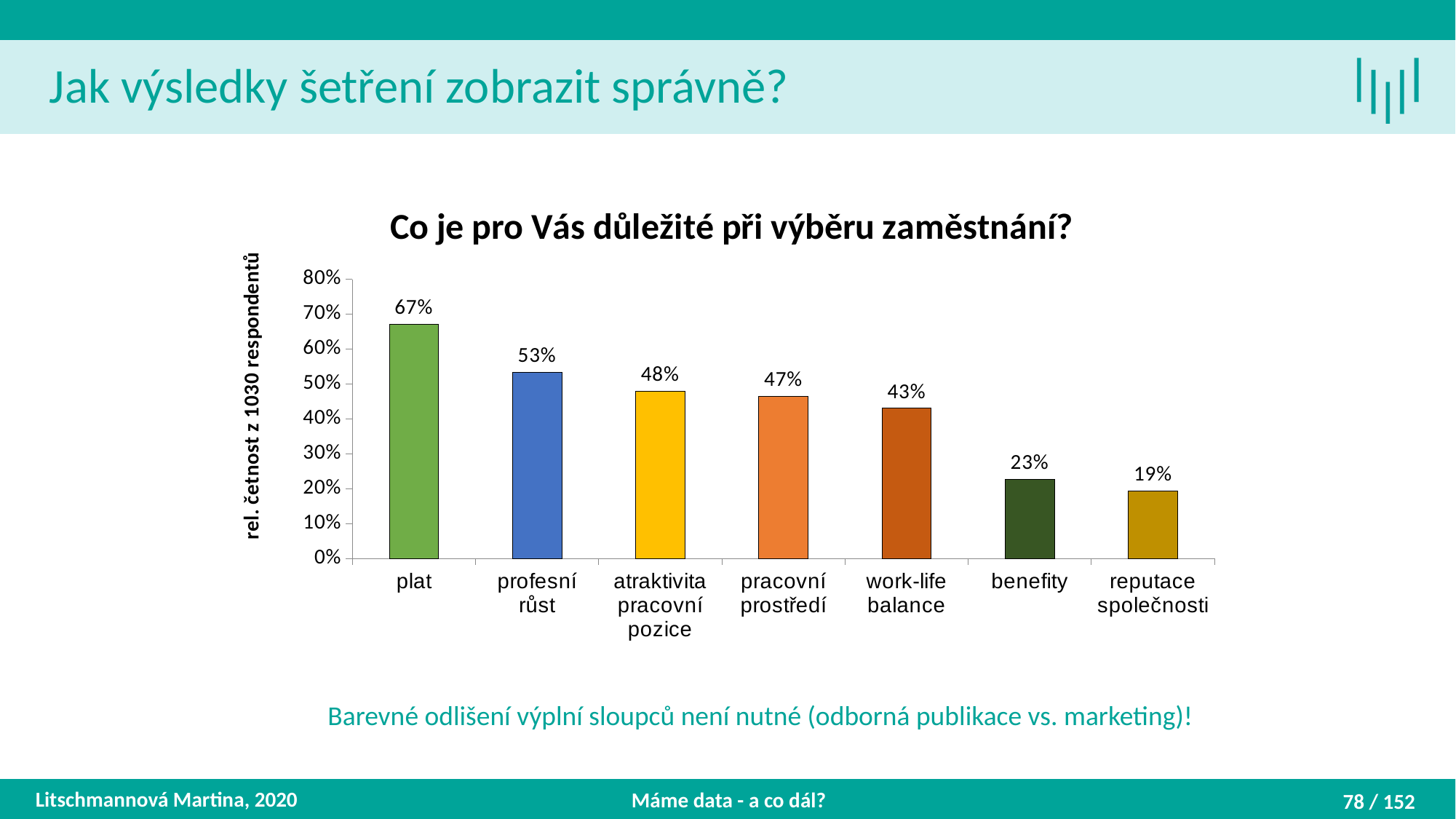
What is the value for "reputace společnosti"? 19% Which category has the lowest value? reputace společnosti Is the value for "pracovní prostředí" greater or less than 40%? greater Which is larger, the value for "profesní růst" or the value for "work-life balance"? profesní růst How many categories are shown in the chart? 7 What kind of chart is shown on the slide? bar chart What is the difference between the values for "benefity" and "reputace společnosti"? 4% What is the value for "plat"? 67% What is the value for "work-life balance"? 43% Which category has the highest value? plat What is the title of the chart? Co je pro Vás důležité při výběru zaměstnání? What is the difference between the values for "plat" and "profesní růst"? 14%